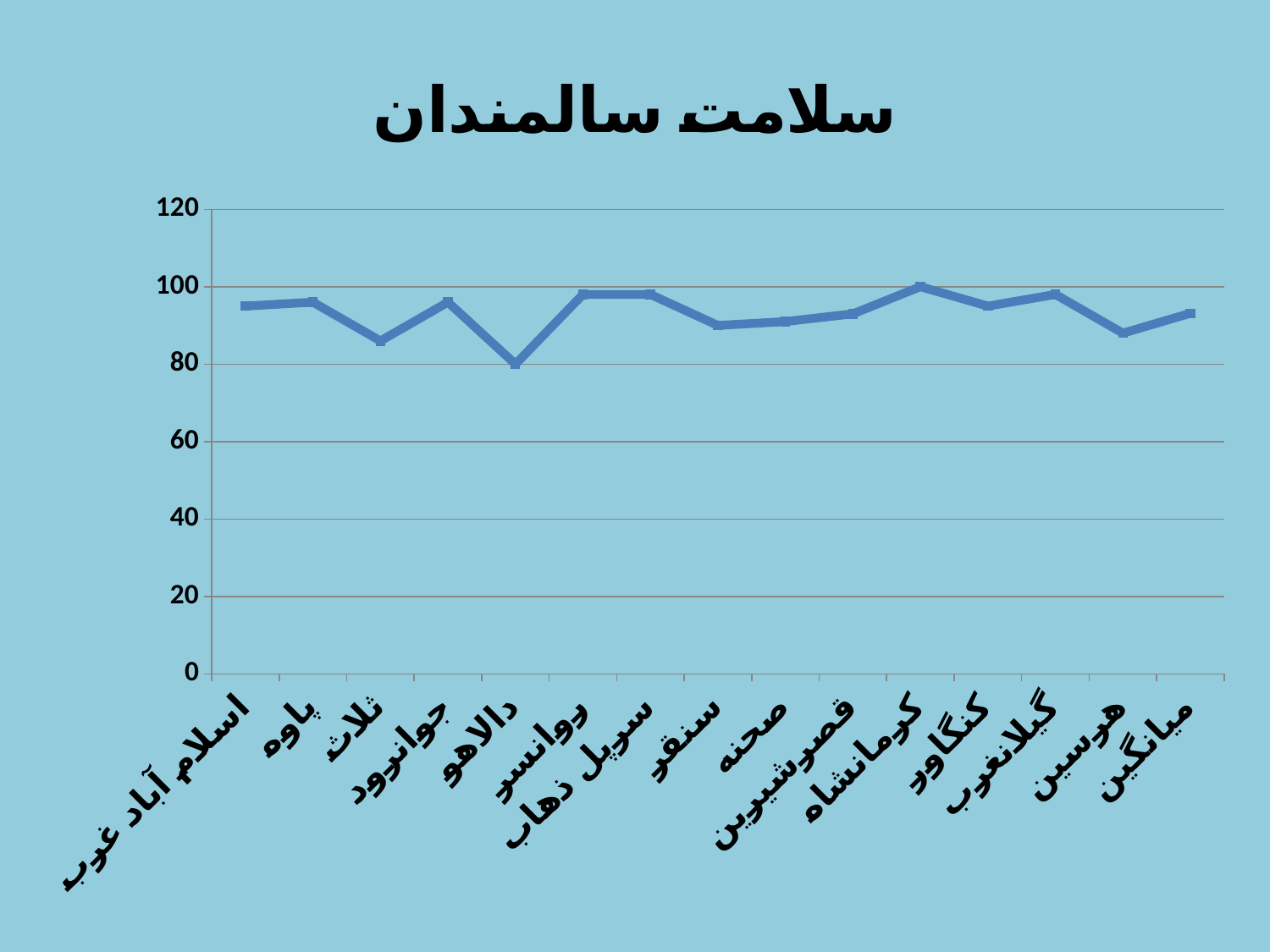
What is the title of the chart? سلامت سالمندان Which is larger, the value for دالاهو or the value for کرمانشاه? کرمانشاه How many categories are plotted along the x axis? 15 Which category has the lowest value? دالاهو Between جوانرود and دالاهو, does the line rise or fall? fall Is the value for کرمانشاه greater or less than 80? greater Which is larger, the value for ثلاث or the value for روانسر? روانسر Is the value for ثلاث greater or less than 80? greater Is the value for دالاهو greater or less than 100? less What kind of chart is shown on the slide? line chart What is the highest value shown on the y axis? 120